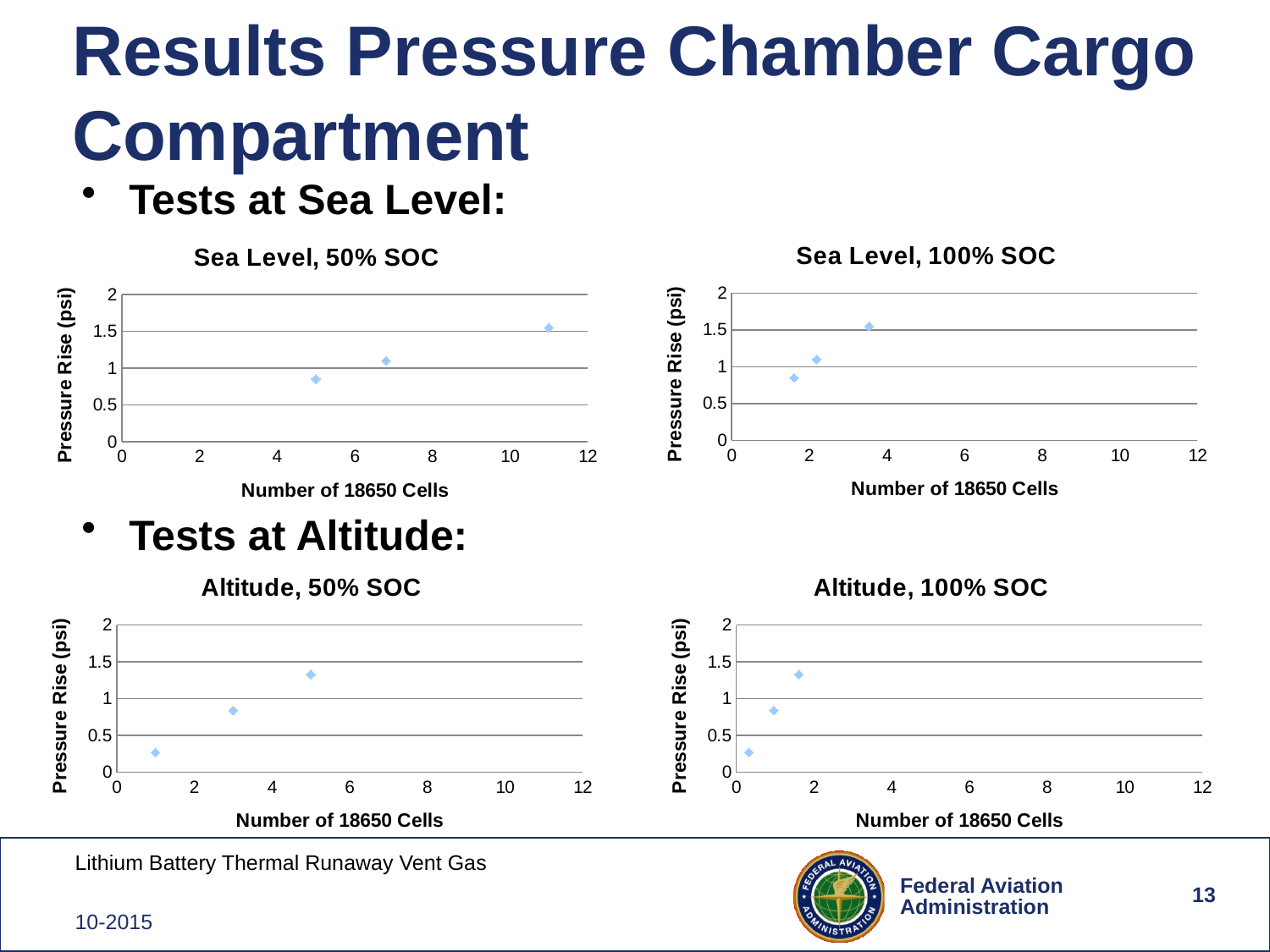
What is the maximum value shown on the y axis of the "Altitude, 50% SOC" chart? 2 In the "Altitude, 100% SOC" chart, is the highest plotted pressure rise greater or less than 1.5 psi? less How many data points are plotted in the "Sea Level, 50% SOC" chart? 3 In the "Sea Level, 50% SOC" chart, does pressure rise increase or decrease as the number of 18650 cells increases? increase In the "Altitude, 50% SOC" chart, is the pressure rise for the point at 1 cell greater or less than 0.5 psi? less In the "Altitude, 50% SOC" chart, does pressure rise increase or decrease as the number of cells increases? increase What is the x-axis label of the "Sea Level, 100% SOC" chart? Number of 18650 Cells How many data points are plotted in the "Altitude, 100% SOC" chart? 3 What kind of chart is the "Sea Level, 50% SOC" chart? scatter chart